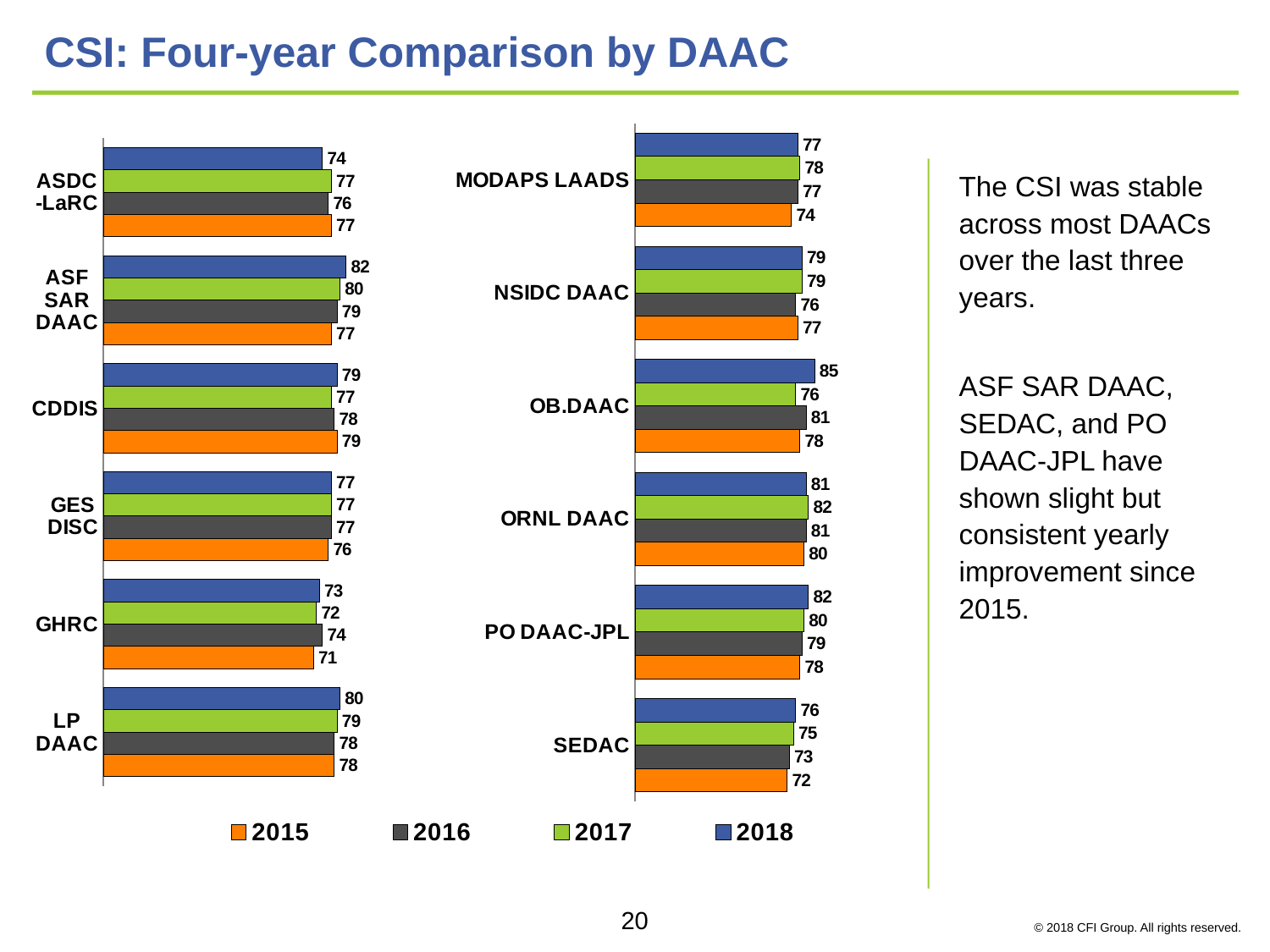
In the right chart, which DAAC has the highest 2018 value? OB.DAAC In the right chart, what is the 2017 value for OB.DAAC? 76 Which colour represents 2015 in the legend? Orange In the left chart, what is the 2018 value for ASF SAR DAAC? 82 In the left chart, which DAAC has the lowest 2015 value? GHRC In the left chart, what is the difference between the 2018 and 2015 values for ASF SAR DAAC? 5 How many DAACs are shown in the left chart? 6 In the right chart, what is the difference between the 2018 and 2015 values for SEDAC? 4 In the right chart, what is the 2015 value for SEDAC? 72 In the left chart, which is larger for GHRC: the 2016 value or the 2017 value? 2016 How many series does the legend list? 4 What kind of chart is used on this slide? Bar chart